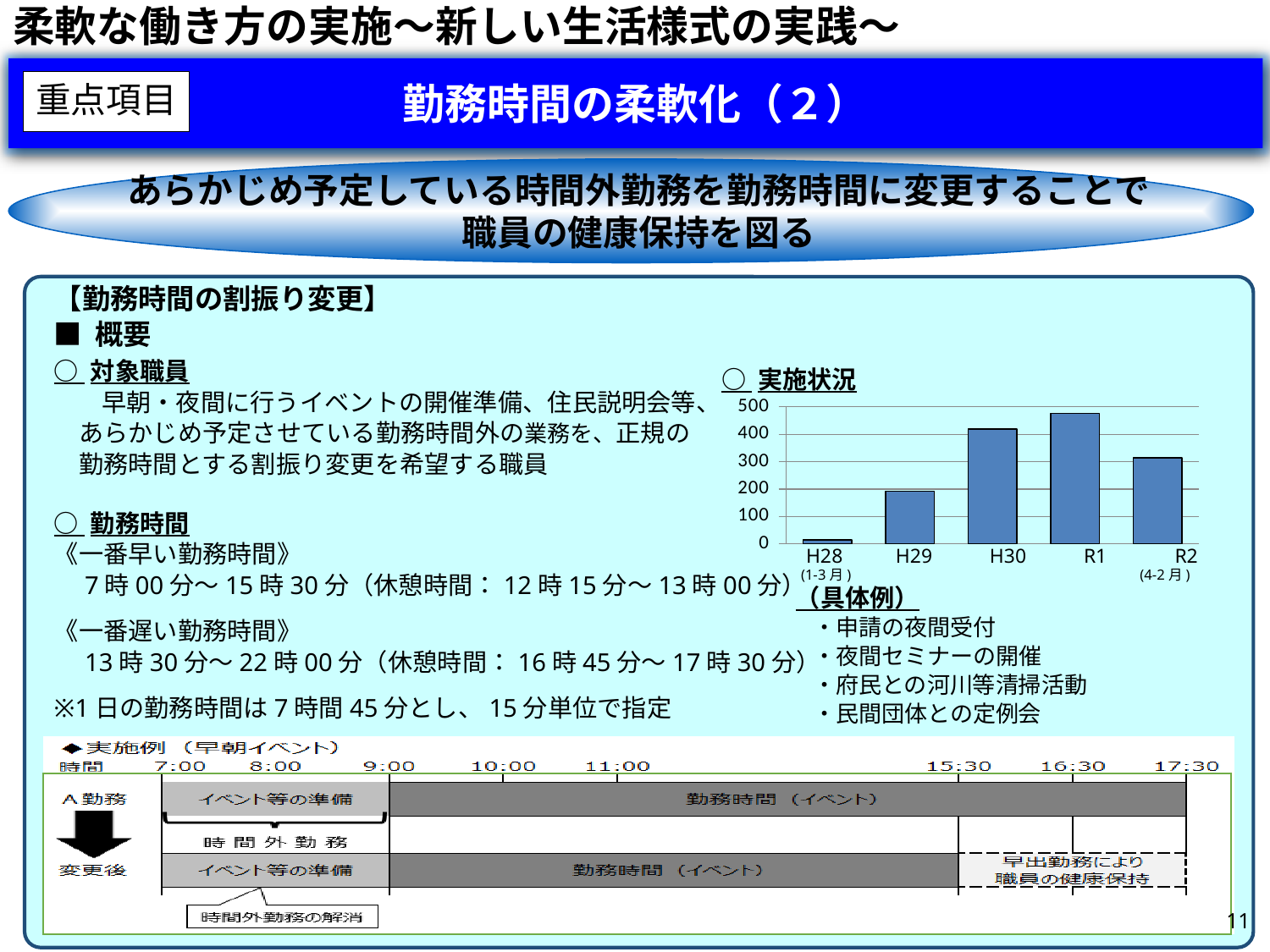
Which category has the lowest value in the 実施状況 chart? H28 Do the values in the 実施状況 chart rise or fall from H28 to R1? rise In the 実施状況 chart, is the value for H30 greater or less than 400? greater In the 実施状況 chart, which is larger, the value for H30 or the value for R2? H30 What is the highest value shown on the y axis of the 実施状況 chart? 500 How many categories are shown on the x axis of the 実施状況 chart? 5 In the 実施状況 chart, is the value for R2 greater or less than 300? greater What kind of chart is shown under 実施状況? bar chart In the 実施状況 chart, which is larger, the value for H29 or the value for R1? R1 Which category has the highest value in the 実施状況 chart? R1 In the 実施状況 chart, is the value for H28 greater or less than 100? less